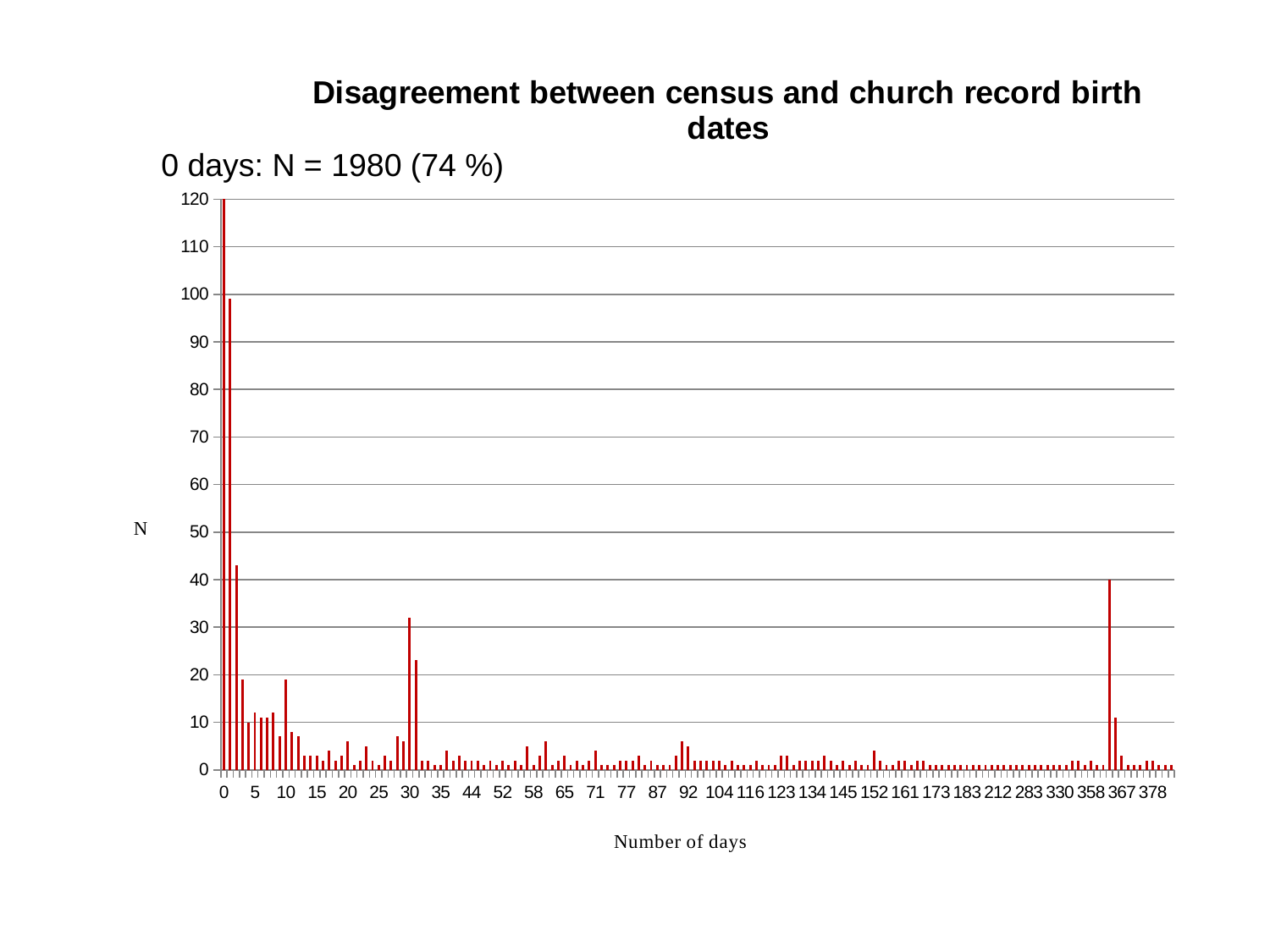
Is the value for 5 days greater or less than 20? less What is the title of the chart? Disagreement between census and church record birth dates Which has a larger value, 30 days or 35 days? 30 days What is the label on the x axis of the chart? Number of days Is the value for 30 days greater or less than 20? greater Which has a larger value, 0 days or 5 days? 0 days Is the value for 10 days greater or less than 30? less What kind of chart is shown on the slide? bar chart Overall, do the bar values rise or fall as the number of days increases from 0 to 15? fall Which has a larger value, 10 days or 15 days? 10 days Which number of days has the highest bar in the chart? 0